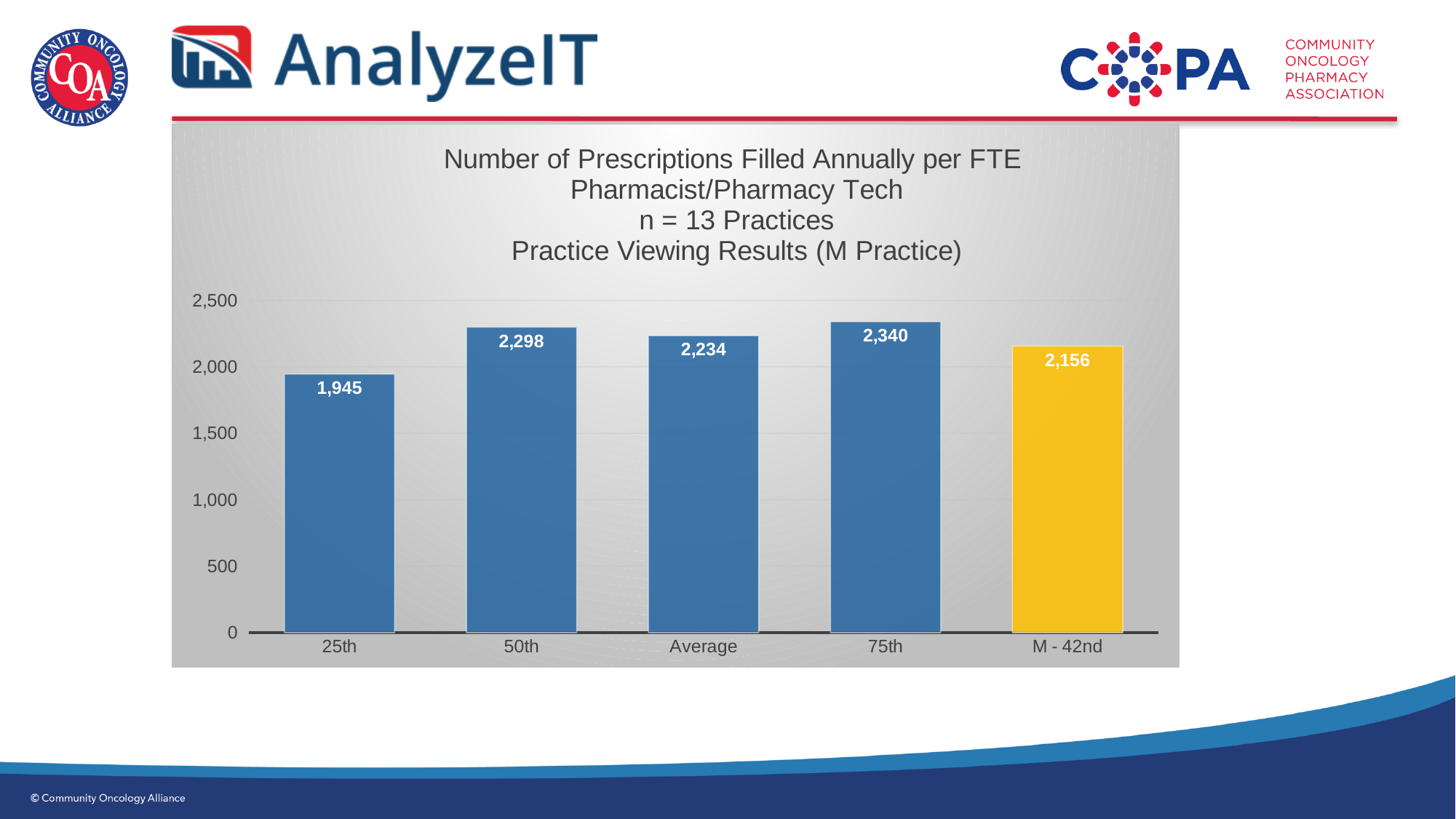
What is the value for the 50th percentile? 2,298 What is the difference between the 75th percentile value and the 25th percentile value? 395 What kind of chart is shown on the slide? bar chart What is the difference between the Average value and the M - 42nd value? 78 Which category has the lowest value? 25th Is the value for 25th greater or less than 2,000? less How many bars are shown in the chart? 5 Which category has the highest value? 75th Which bar is coloured differently (yellow) from the others? M - 42nd What is the value for the M - 42nd bar? 2,156 Which is larger, the value for 50th or the value for Average? 50th What is the value for the 25th percentile? 1,945